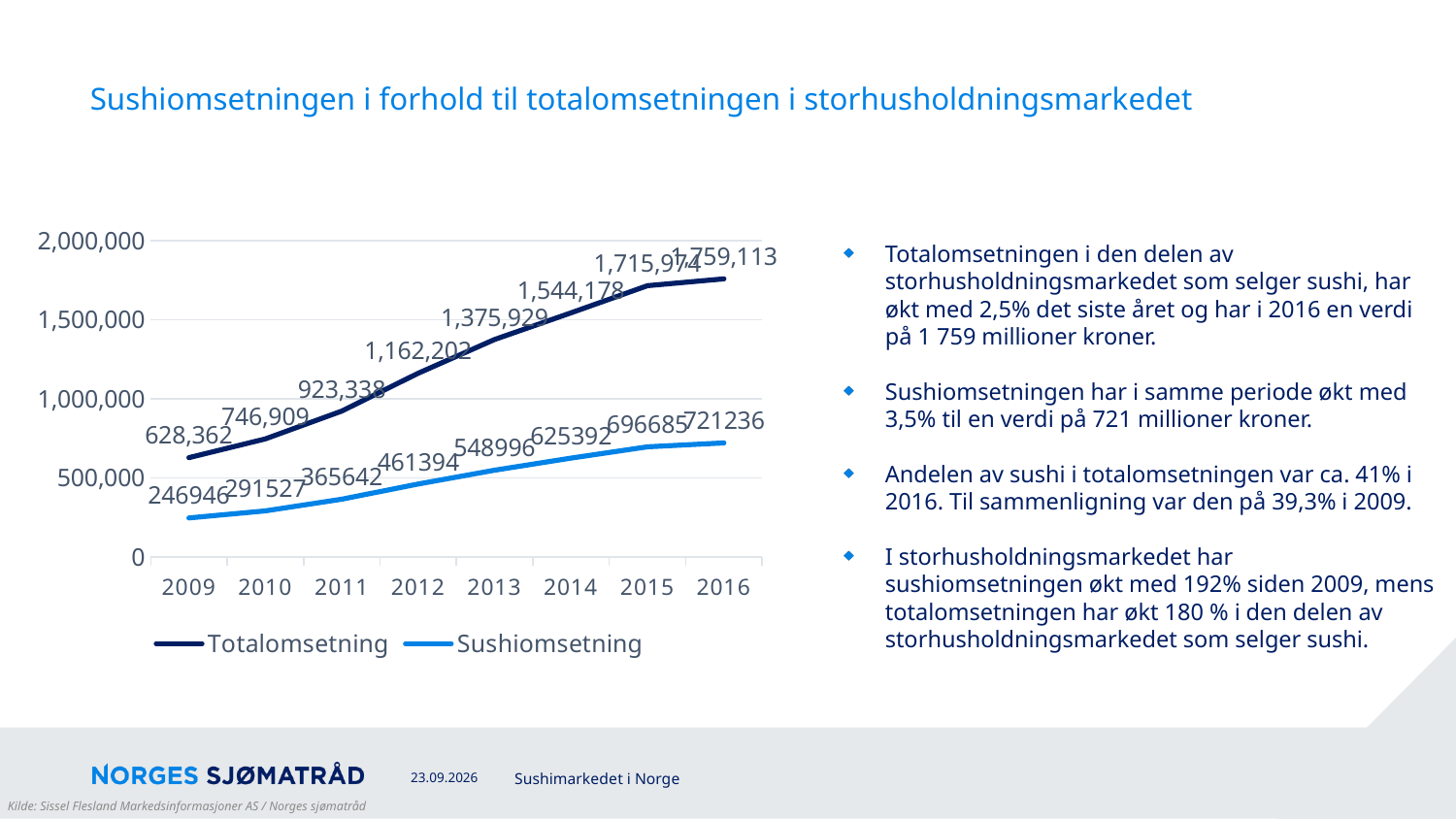
In which year is Totalomsetning highest? 2016 Which is larger in 2013, Totalomsetning or Sushiomsetning? Totalomsetning What is the value of Totalomsetning in 2009? 628,362 In which year is Sushiomsetning lowest? 2009 What kind of chart is shown on the slide? line chart What is the value of Sushiomsetning in 2012? 461394 What is the difference between Sushiomsetning in 2016 and in 2015? 24551 Is the value for Sushiomsetning in 2014 greater or less than 500,000? greater How many series does the chart legend list? 2 Do the Sushiomsetning values rise or fall from 2009 to 2016? rise What is the value of Sushiomsetning in 2016? 721236 How many years are plotted along the x axis of the chart? 8